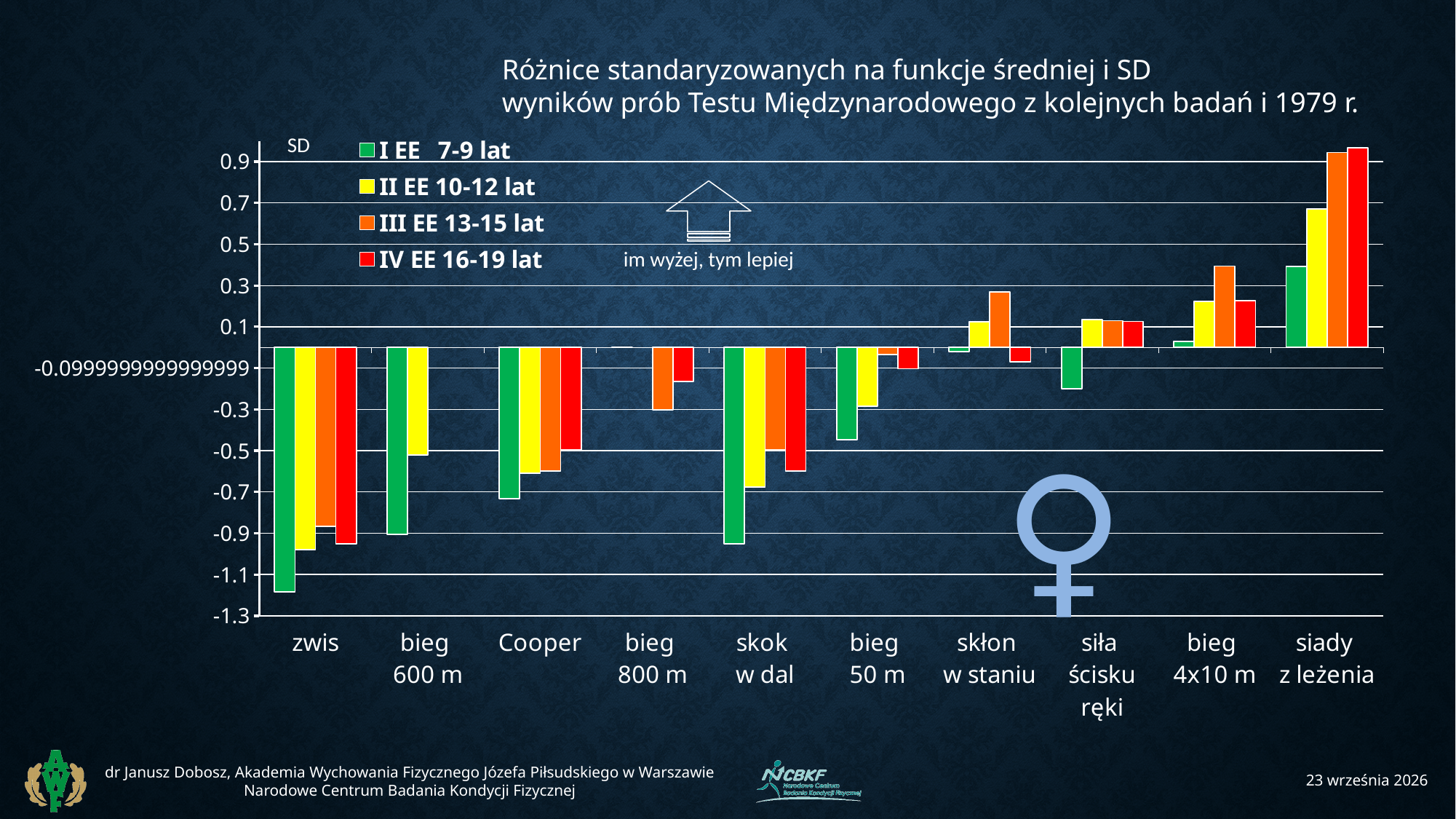
How many test categories are shown along the x axis? 10 How many series does the legend list? 4 Which category and series has the lowest value on the chart? zwis, I EE 7-9 lat Is the value for I EE 7-9 lat in the zwis category greater or less than -1.1? less Which colour represents the IV EE 16-19 lat series in the legend? red Is the value for II EE 10-12 lat in the siady z leżenia category greater or less than 0.5? greater What kind of chart is shown on the slide? bar chart Is the value for I EE 7-9 lat in the Cooper category greater or less than -0.5? less Which category has the highest values on the chart? siady z leżenia Which is larger for I EE 7-9 lat: the value for zwis or the value for bieg 600 m? bieg 600 m